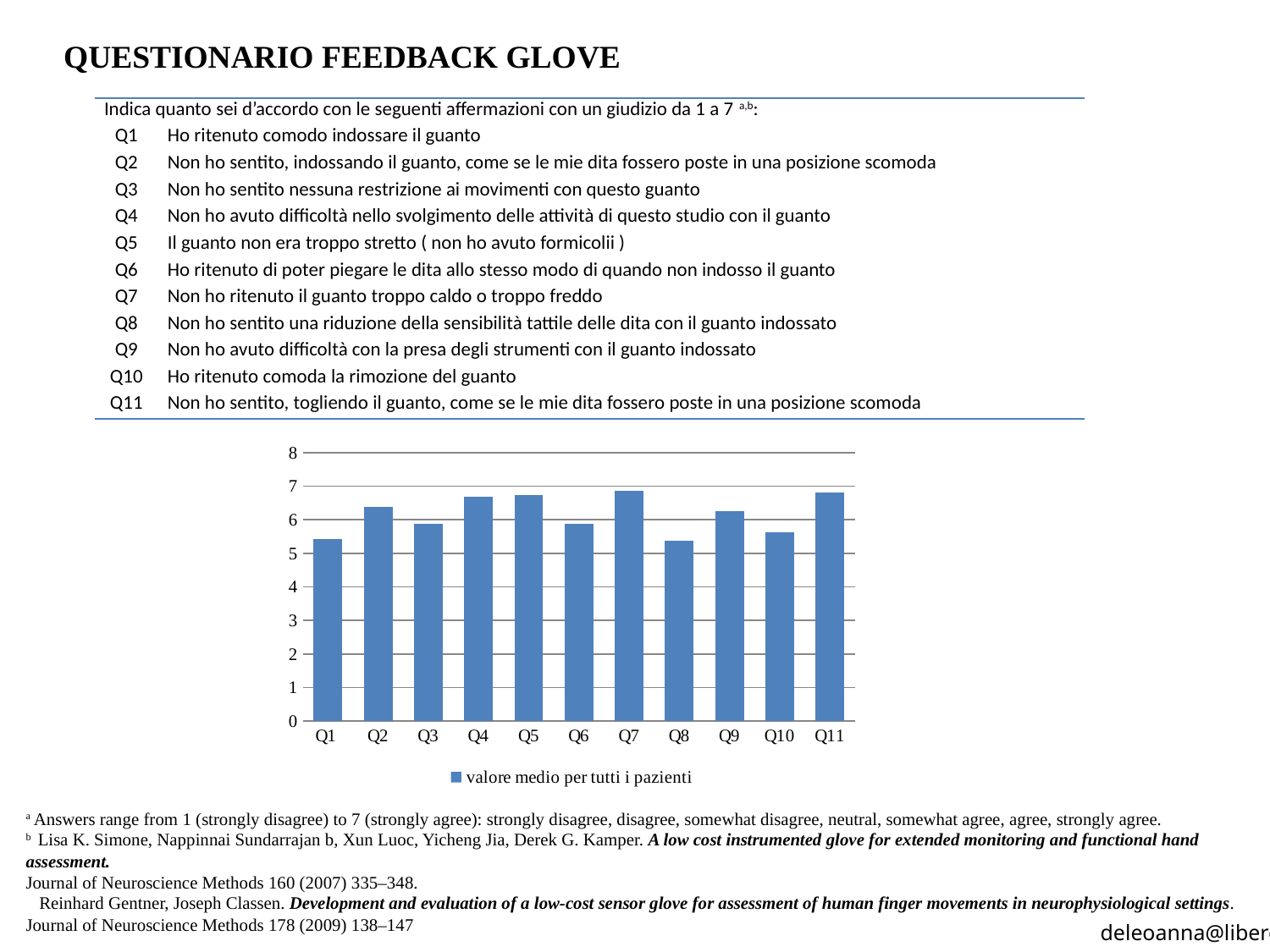
What kind of chart is shown on the slide? bar chart How many categories (questions) are plotted on the x axis of the chart? 11 What is the highest value shown on the vertical axis of the chart? 8 Which has the larger value, Q7 or Q8? Q7 Is the value for Q10 greater or less than 6? less Is the value for Q1 greater or less than 6? less Is the value for Q8 greater or less than 6? less What is the legend entry of the series shown in the chart? valore medio per tutti i pazienti How many series does the chart legend list? 1 Which has the larger value, Q2 or Q1? Q2